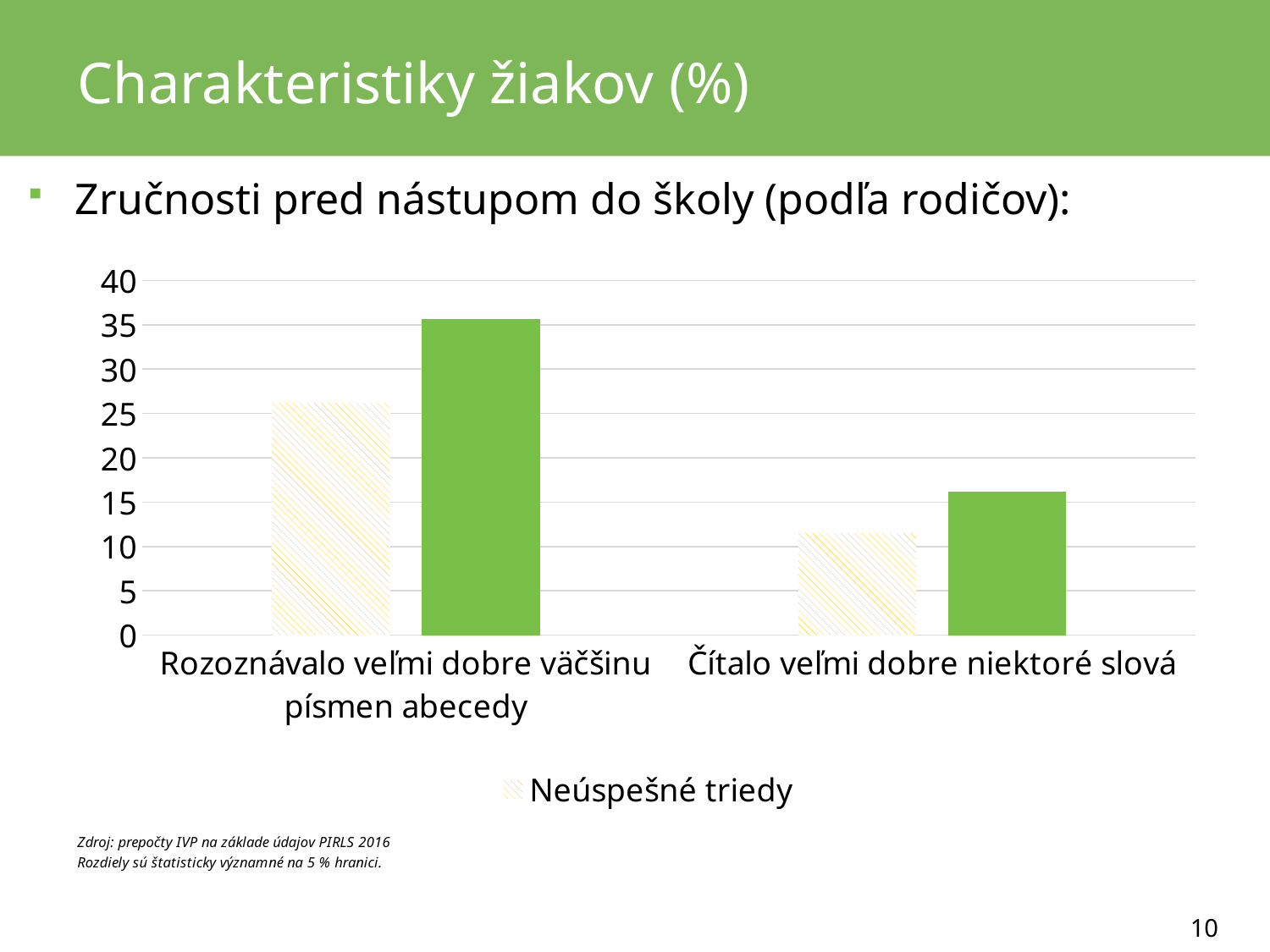
Which bar in the chart is the highest? the green bar for 'Rozoznávalo veľmi dobre väčšinu písmen abecedy' Is the value of the hatched 'Neúspešné triedy' bar for 'Rozoznávalo veľmi dobre väčšinu písmen abecedy' greater or less than 30? less Is the value of the hatched 'Neúspešné triedy' bar for 'Čítalo veľmi dobre niektoré slová' greater or less than 15? less Which bar in the chart is the lowest? the hatched 'Neúspešné triedy' bar for 'Čítalo veľmi dobre niektoré slová' What is the maximum value shown on the chart's vertical axis? 40 What is the series name shown in the chart's legend? Neúspešné triedy What kind of chart is shown on the slide? bar chart Is the value of the green bar for 'Čítalo veľmi dobre niektoré slová' greater or less than 20? less For 'Rozoznávalo veľmi dobre väčšinu písmen abecedy', which bar is larger: the hatched 'Neúspešné triedy' bar or the green bar? the green bar How many categories are shown on the x axis of the chart? 2 How many series does the chart's legend list? 1